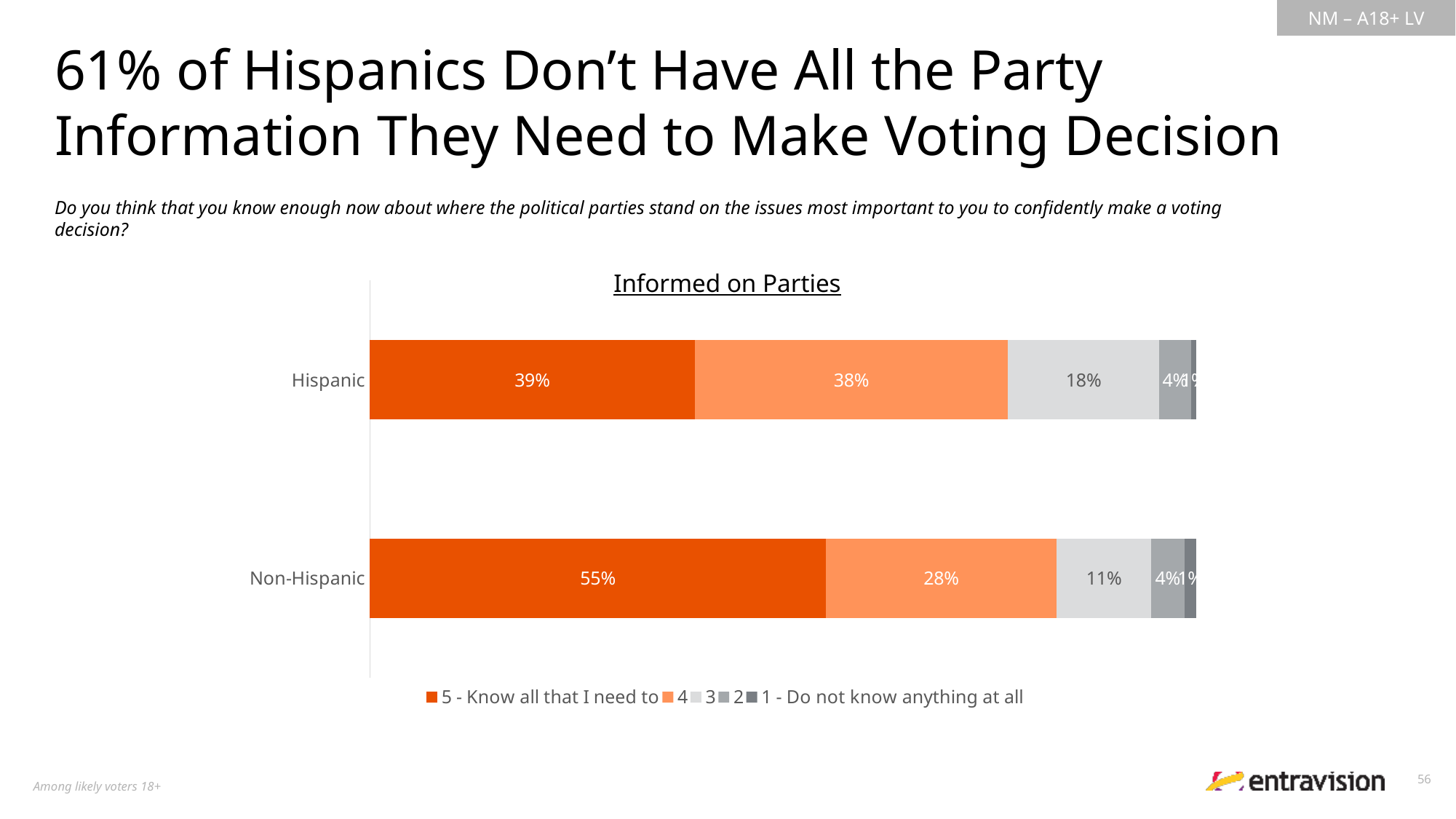
What kind of chart is shown on the slide? Stacked bar chart What is the difference between the Hispanic and Non-Hispanic shares for rating 4? 10 percentage points What percentage of Non-Hispanics gave a rating of 3? 11% What percentage of Hispanics gave a rating of 4? 38% What percentage of Non-Hispanics answered '5 - Know all that I need to'? 55% What is the difference between the Non-Hispanic and Hispanic shares for '5 - Know all that I need to'? 16 percentage points Which group has the larger share for rating 3, Hispanic or Non-Hispanic? Hispanic Which group has the higher share for '5 - Know all that I need to'? Non-Hispanic What percentage of Hispanics answered '5 - Know all that I need to'? 39% How many categories (bars) are shown in the chart? 2 What is the title of the chart? Informed on Parties How many series does the legend list? 5